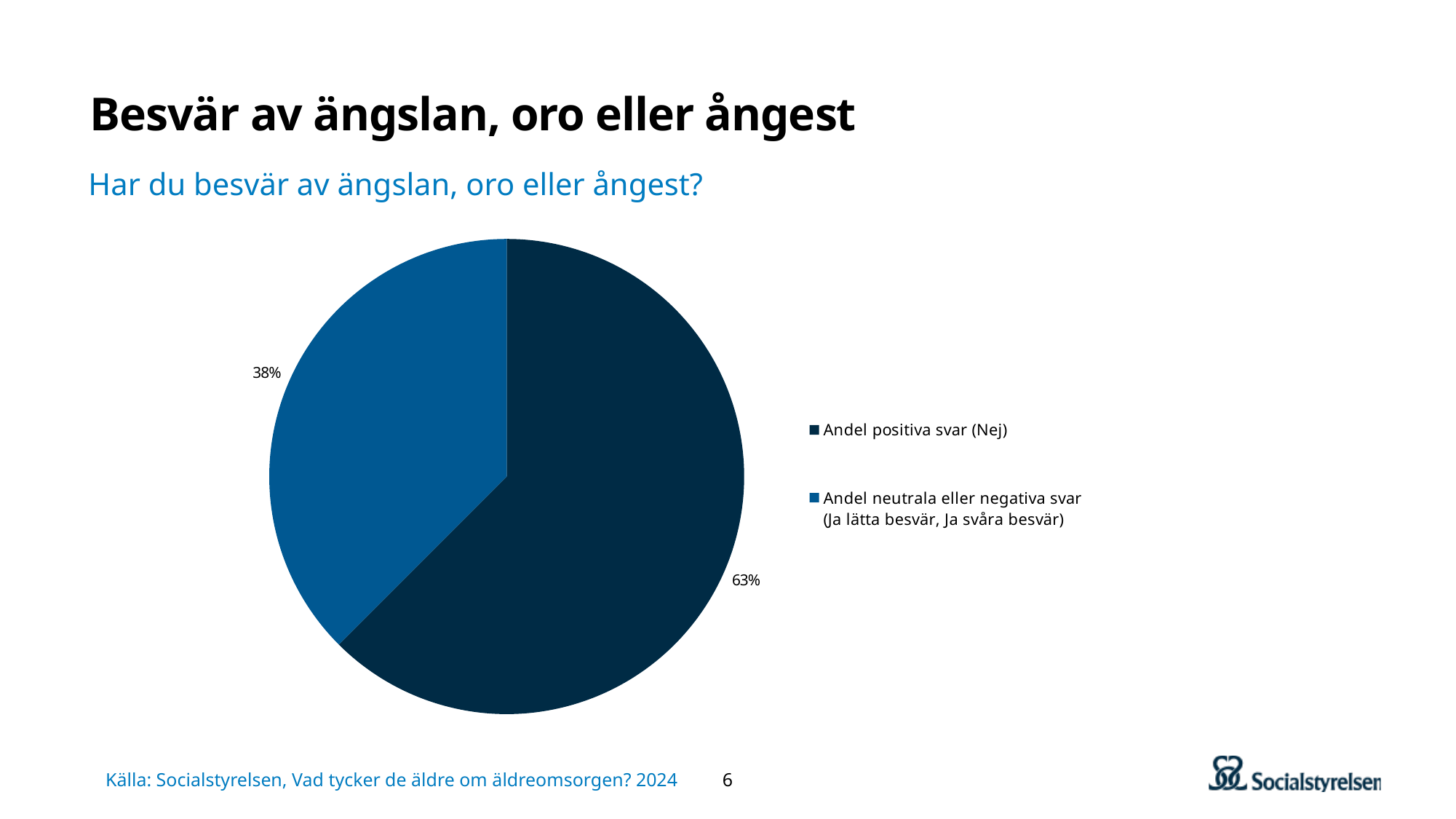
What is the difference in percentage points between the two slices of the pie? 25 How many entries does the legend list? 2 What share of the pie is labelled "Andel neutrala eller negativa svar (Ja lätta besvär, Ja svåra besvär)"? 38% Which slice of the pie is the smallest? Andel neutrala eller negativa svar (Ja lätta besvär, Ja svåra besvär) What kind of chart is shown on the slide? pie chart What question is shown as the chart's subtitle? Har du besvär av ängslan, oro eller ångest? What share of the pie is labelled "Andel positiva svar (Nej)"? 63% Which legend entry is shown in the darker blue colour? Andel positiva svar (Nej) How many slices does the pie chart have? 2 Which slice of the pie is the largest? Andel positiva svar (Nej) Which is larger: the share of positive answers (Nej) or the share of neutral or negative answers? Andel positiva svar (Nej)